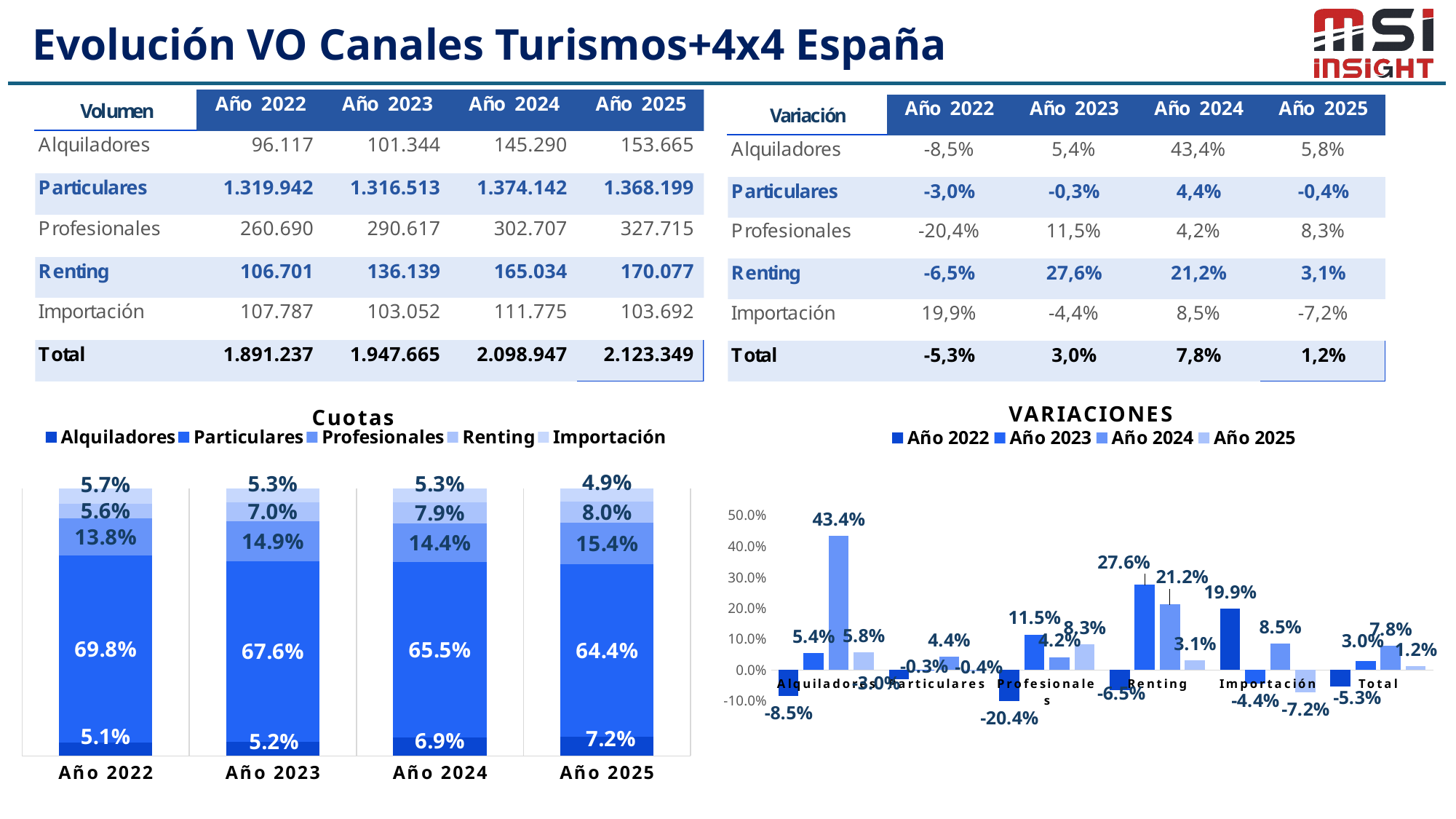
In the VARIACIONES chart, which category has the highest value in Año 2023? Renting In the Cuotas chart, what is the share for Alquiladores in Año 2024? 6.9% In the Cuotas chart, does the Particulares share rise or fall from Año 2022 to Año 2025? fall In the VARIACIONES chart, which is larger: Importación in Año 2022 or Renting in Año 2024? Renting in Año 2024 In the Cuotas chart, what is the share for Particulares in Año 2022? 69.8% In the Cuotas chart, what is the share for Profesionales in Año 2025? 15.4% In the Cuotas chart, how many series does the legend list? 5 In the Cuotas chart, what is the difference between the Renting share in Año 2025 and in Año 2022? 2.4% What kind of chart is the Cuotas chart? stacked bar chart In the VARIACIONES chart, what is the value for Alquiladores in Año 2024? 43.4% In the VARIACIONES chart, how many categories are shown on the x axis? 6 In the VARIACIONES chart, what is the value for Profesionales in Año 2022? -20.4%